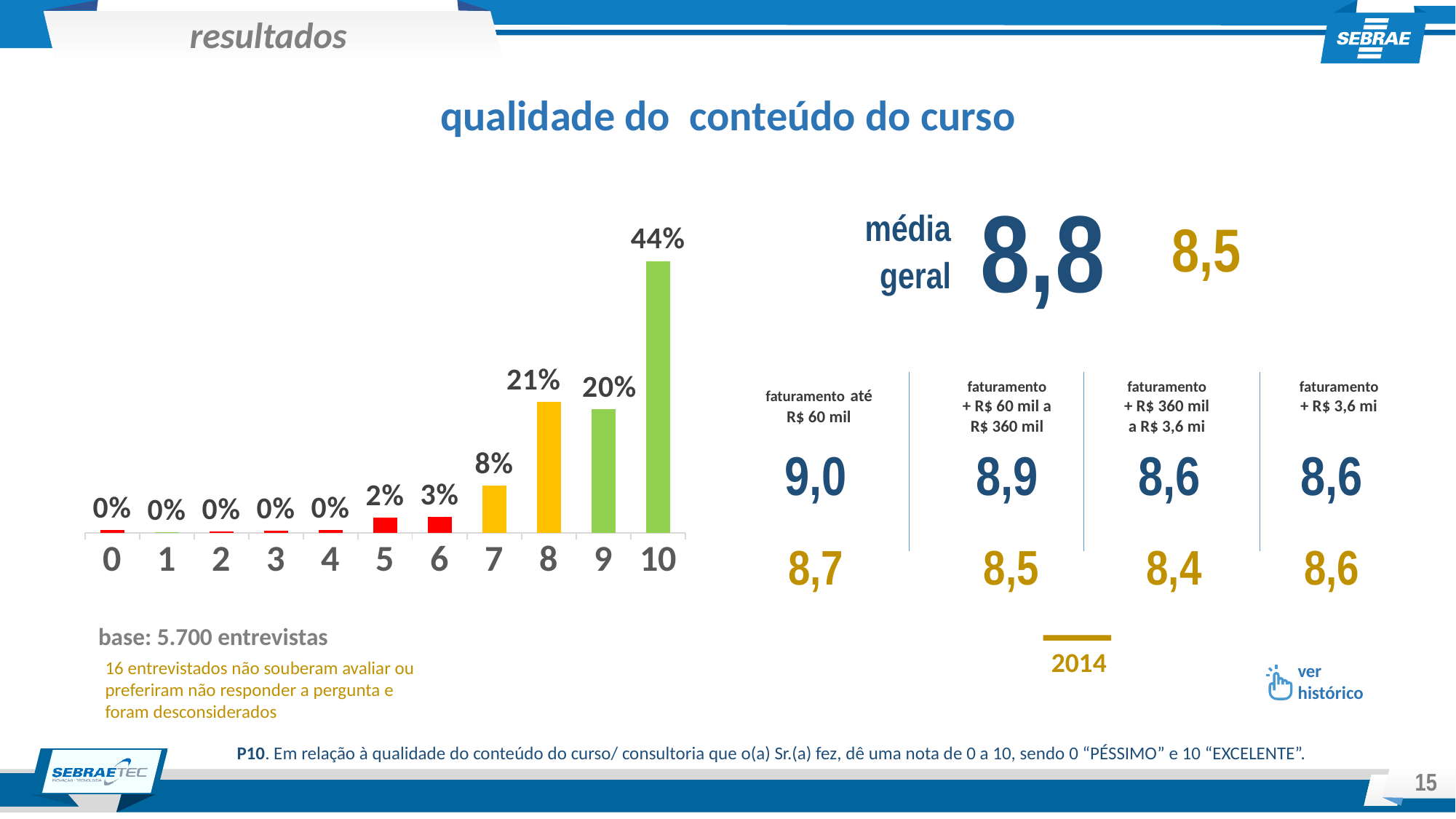
Which score has the highest percentage of respondents? 10 What percentage of respondents gave a score of 7? 8% Which has a larger percentage: score 8 or score 9? Score 8 What colour are the bars for scores 9 and 10? Green What type of chart is used to show the distribution of scores? Bar chart What is the difference in percentage points between the score 10 bar and the score 8 bar? 23% What percentage of respondents gave a score of 8? 21% What percentage of respondents gave a score of 10 for the quality of the course content? 44% How many score categories are shown on the x axis of the bar chart? 11 How many score categories show 0%? 5 What is the combined percentage for scores 9 and 10? 64% What percentage of respondents gave a score of 5? 2%